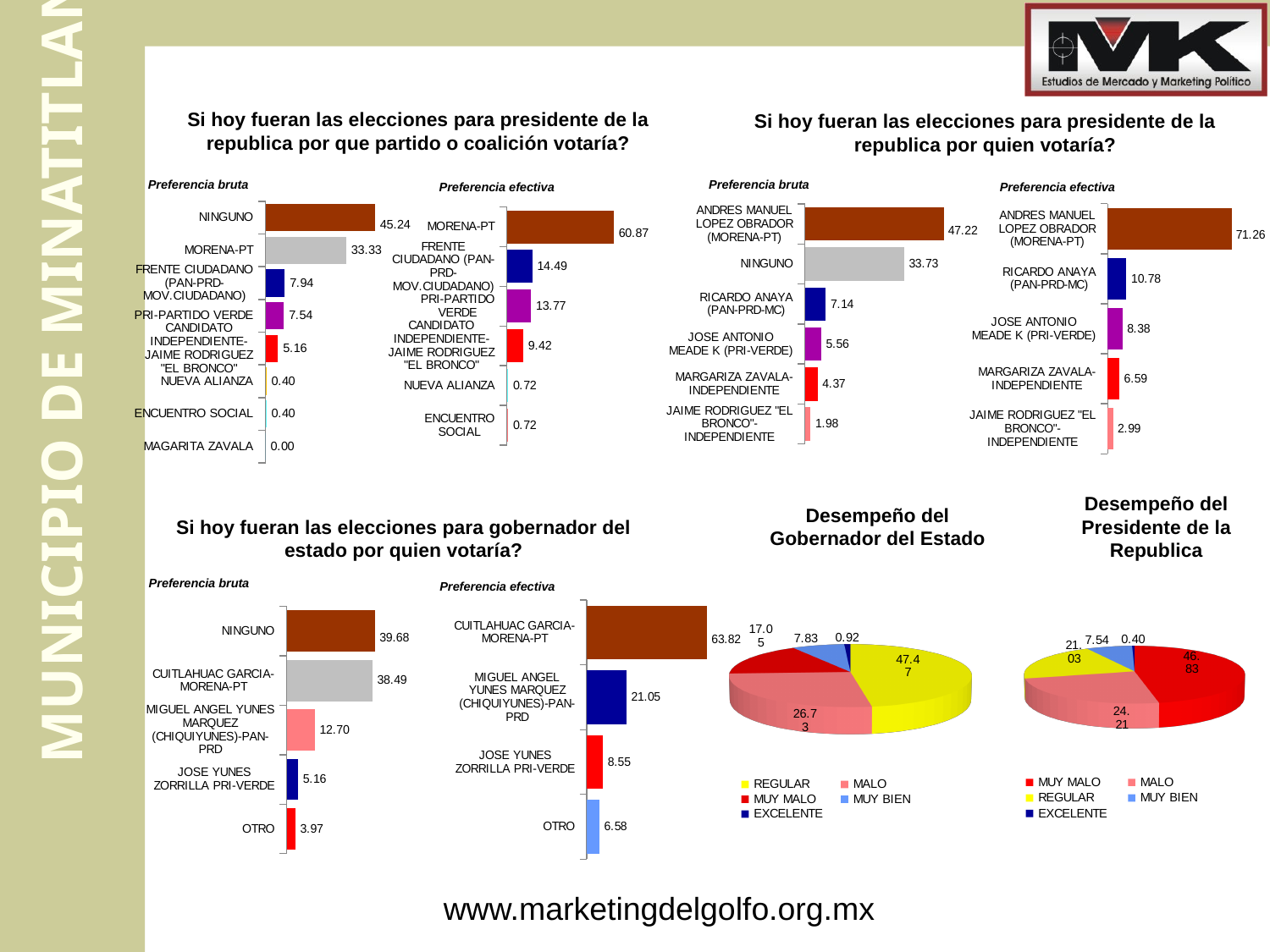
What kind of chart is 'Desempeño del Gobernador del Estado'? Pie chart In the 'Preferencia efectiva' bar chart under 'Si hoy fueran las elecciones para presidente de la republica por quien votaría?', which category has the lowest value? JAIME RODRIGUEZ "EL BRONCO"-INDEPENDIENTE In the 'Preferencia bruta' bar chart under 'Si hoy fueran las elecciones para presidente de la republica por que partido o coalición votaría?', what is the value for MORENA-PT? 33.33 In the 'Preferencia bruta' bar chart under 'Si hoy fueran las elecciones para gobernador del estado por quien votaría?', which is larger: NINGUNO or CUITLAHUAC GARCIA-MORENA-PT? NINGUNO In the 'Desempeño del Presidente de la Republica' pie chart, which category has the largest slice? MUY MALO In the 'Preferencia bruta' bar chart under 'Si hoy fueran las elecciones para gobernador del estado por quien votaría?', how many categories are shown? 5 In the 'Preferencia bruta' bar chart under 'Si hoy fueran las elecciones para presidente de la republica por quien votaría?', what is the value for RICARDO ANAYA (PAN-PRD-MC)? 7.14 In the 'Preferencia bruta' bar chart under 'Si hoy fueran las elecciones para presidente de la republica por que partido o coalición votaría?', what is the value for MAGARITA ZAVALA? 0.00 In the 'Preferencia efectiva' bar chart under 'Si hoy fueran las elecciones para presidente de la republica por quien votaría?', what is the difference between ANDRES MANUEL LOPEZ OBRADOR (MORENA-PT) and RICARDO ANAYA (PAN-PRD-MC)? 60.48 How many entries does the legend of the 'Desempeño del Presidente de la Republica' chart list? 5 In the 'Preferencia efectiva' bar chart under 'Si hoy fueran las elecciones para gobernador del estado por quien votaría?', what is the value for JOSE YUNES ZORRILLA PRI-VERDE? 8.55 In the 'Preferencia efectiva' bar chart under 'Si hoy fueran las elecciones para presidente de la republica por que partido o coalición votaría?', which category has the highest value? MORENA-PT